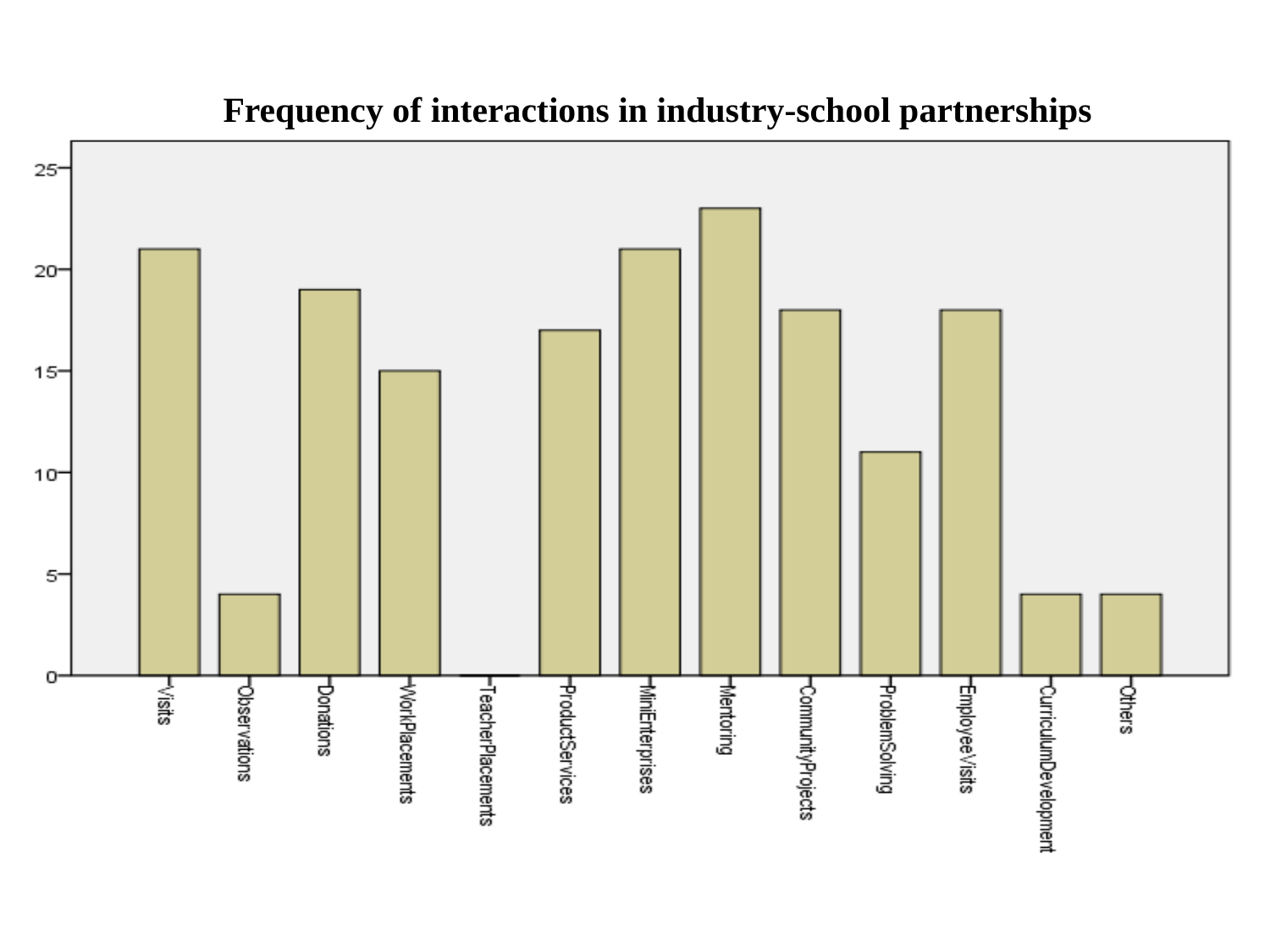
Is the value for Observations greater or less than 5? less What is the title of the chart? Frequency of interactions in industry-school partnerships What is the value for WorkPlacements? 15 Which category has the lowest frequency? TeacherPlacements Which category has the highest frequency? Mentoring Which is larger, the value for Visits or the value for Observations? Visits Is the value for Mentoring greater or less than 20? greater What type of chart is shown on the slide? bar chart What is the value for TeacherPlacements? 0 Which is larger, the value for Donations or the value for WorkPlacements? Donations Is the value for ProblemSolving greater or less than 10? greater How many categories are shown on the x axis of the chart? 13